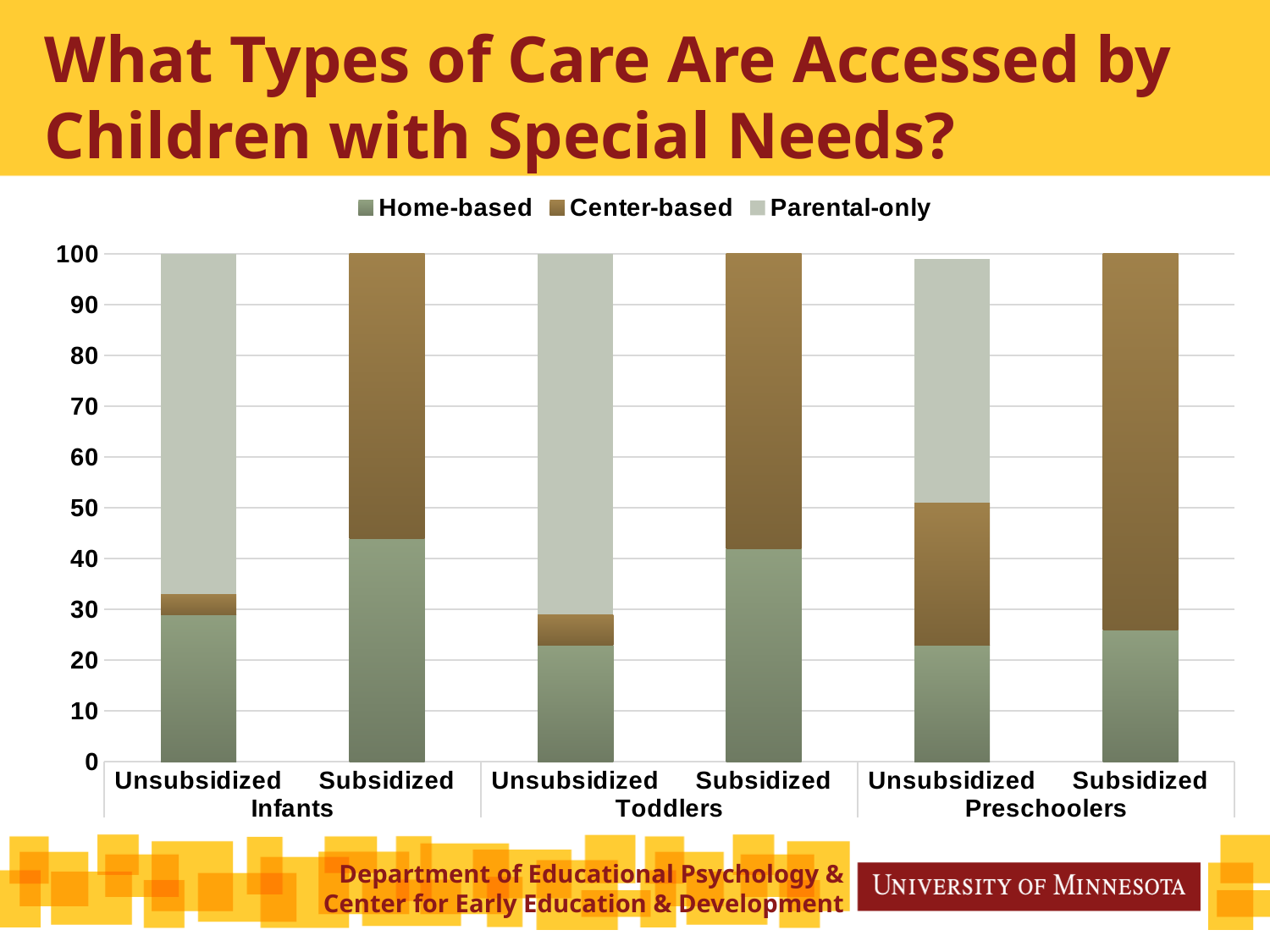
How many bars are plotted in the chart? 6 Is the Home-based value for Subsidized Infants greater or less than 40? greater How many series does the legend list? 3 Is the Home-based value for Subsidized Preschoolers greater or less than 30? less Which series is shown in the lightest colour in the legend? Parental-only Which three age groups are shown along the x axis? Infants, Toddlers, Preschoolers Which has the larger Home-based value: Unsubsidized Infants or Subsidized Infants? Subsidized Infants Which has the larger Parental-only segment: Unsubsidized Infants or Unsubsidized Preschoolers? Unsubsidized Infants Among the Unsubsidized bars, which age group has the smallest Parental-only segment? Preschoolers What kind of chart is shown on the slide? Stacked bar chart Is the Home-based value for Unsubsidized Toddlers greater or less than 30? less